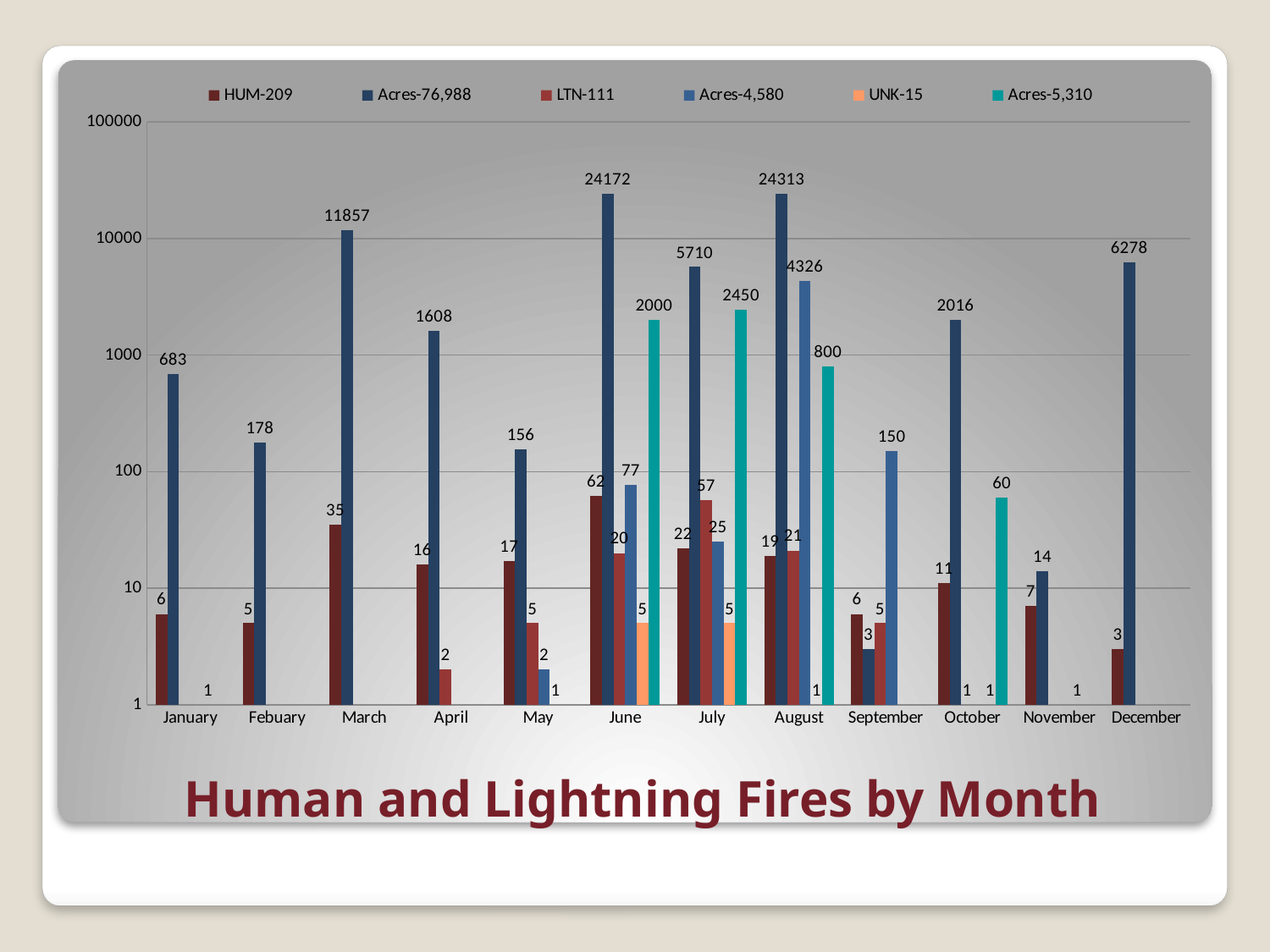
What kind of chart is shown on the slide? bar chart In July, which is larger: the HUM-209 value or the LTN-111 value? LTN-111 What is the difference between the HUM-209 value and the LTN-111 value in June? 42 In which month is the Acres-76,988 value highest? August What is the HUM-209 value for March? 35 How many series does the legend list? 6 In which month is the HUM-209 value lowest? December How many months are shown along the x axis? 12 What is the Acres-4,580 value for September? 150 What is the title of the chart? Human and Lightning Fires by Month What is the Acres-76,988 value for August? 24313 What is the Acres-5,310 value for July? 2450